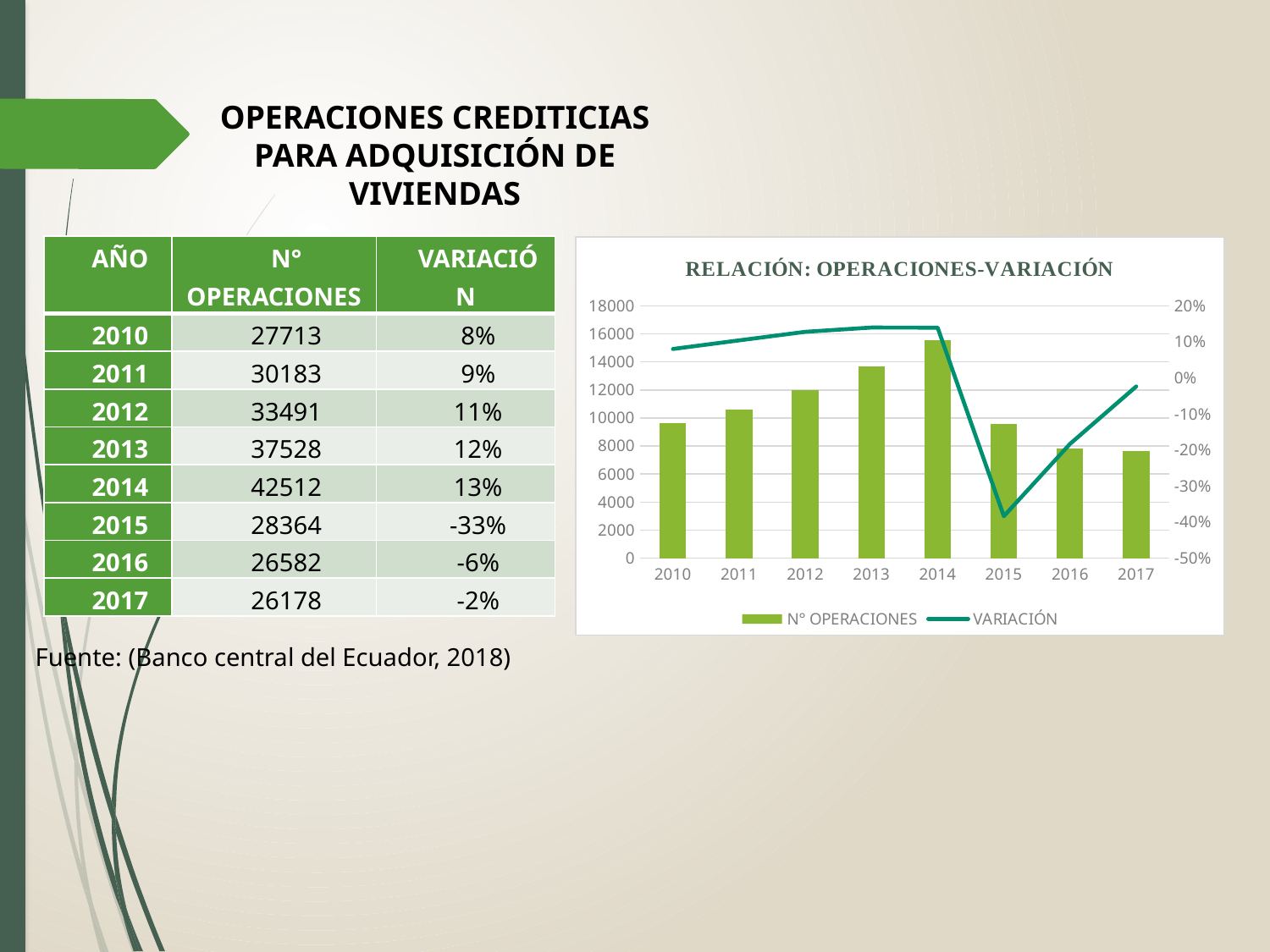
In the chart, do the N° OPERACIONES bars rise or fall from 2010 to 2014? rise In the chart, which year has the lowest point on the VARIACIÓN line? 2015 How many series does the chart's legend list? 2 What is the title of the chart on the slide? RELACIÓN: OPERACIONES-VARIACIÓN How many years are shown on the x axis of the chart? 8 In the chart, which N° OPERACIONES bar is taller, 2013 or 2012? 2013 In the chart, is the N° OPERACIONES bar for 2012 greater or less than 14000? less In the chart, is the N° OPERACIONES bar for 2014 greater or less than 14000? greater What are the two series named in the chart's legend? N° OPERACIONES and VARIACIÓN In the chart, which year has the tallest N° OPERACIONES bar? 2014 What kind of chart is shown on the slide? Combined bar and line chart In the chart, is the VARIACIÓN value for 2015 greater or less than -30%? less